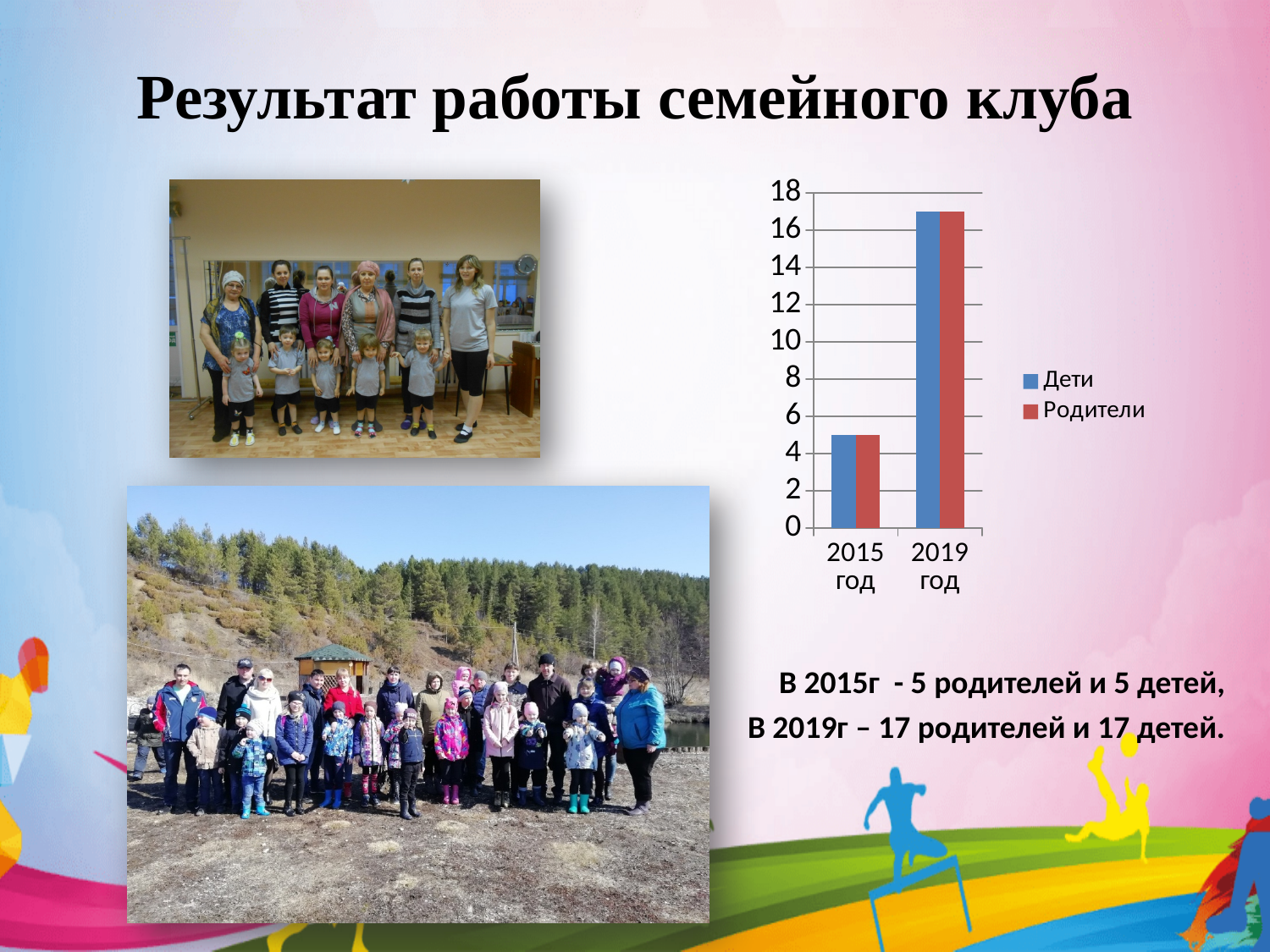
Is the value for Родители in 2015 год greater or less than 6? less Which year has the higher value for Дети, 2015 год or 2019 год? 2019 год Which colour represents Родители in the chart? red What are the two series named in the chart legend? Дети, Родители What is the difference between the Дети values for 2019 год and 2015 год? 12 How many series does the chart legend list? 2 What is the value for Родители in 2019 год? 17 Is the value for Дети in 2019 год greater or less than 16? greater What kind of chart is shown on the slide? bar chart Do the values for Родители rise or fall from 2015 год to 2019 год? rise How many categories are shown on the x axis of the chart? 2 What is the value for Дети in 2015 год? 5